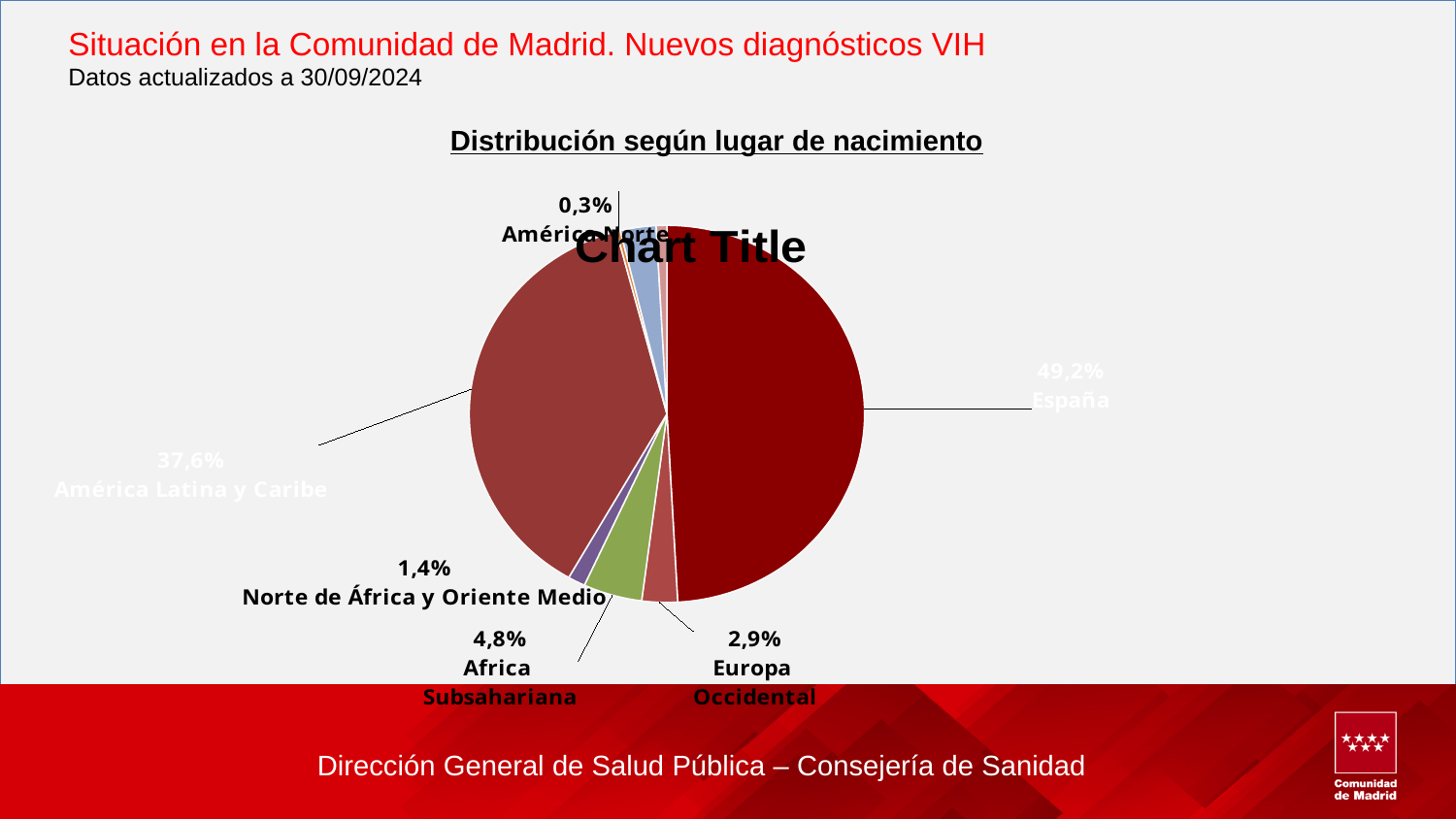
What is the heading written above the pie chart? Distribución según lugar de nacimiento What percentage is shown for América Norte? 0,3% Which is larger, the slice for Africa Subsahariana or the slice for Europa Occidental? Africa Subsahariana What kind of chart is shown on the slide? pie chart How many percentage points larger is the España slice than the América Latina y Caribe slice? 11,6% What percentage is labelled for Europa Occidental? 2,9% Which labelled place of birth has the smallest slice of the pie? América Norte What percentage of new HIV diagnoses corresponds to España? 49,2% What is the value shown for Africa Subsahariana? 4,8% What share does América Latina y Caribe have in the pie chart? 37,6% Which place of birth has the largest slice of the pie? España What is the share for Norte de África y Oriente Medio? 1,4%